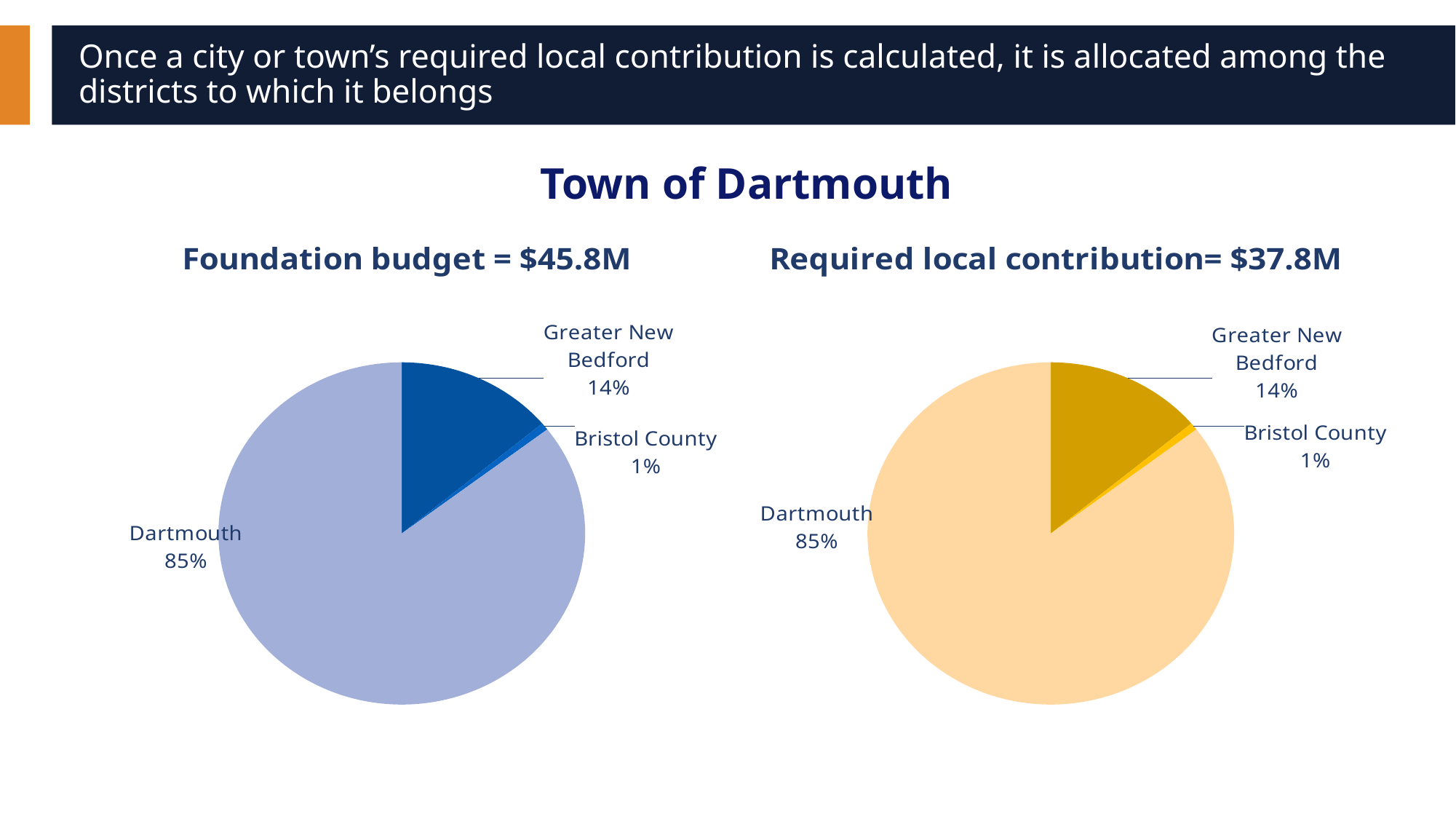
In the Required local contribution chart, which is larger, Greater New Bedford or Bristol County? Greater New Bedford In the Required local contribution chart, what share does Dartmouth have? 85% In the Foundation budget chart, which district has the largest slice? Dartmouth In the Foundation budget chart, what share does Bristol County have? 1% What type of chart is the Required local contribution chart? Pie chart In the Foundation budget chart, what share does Greater New Bedford have? 14% In the Foundation budget chart, what is the difference in percentage points between Dartmouth and Greater New Bedford? 71 In the Required local contribution chart, which district has the smallest slice? Bristol County What is the total foundation budget stated in the title of the left chart? $45.8M How many slices does the Foundation budget chart have? 3